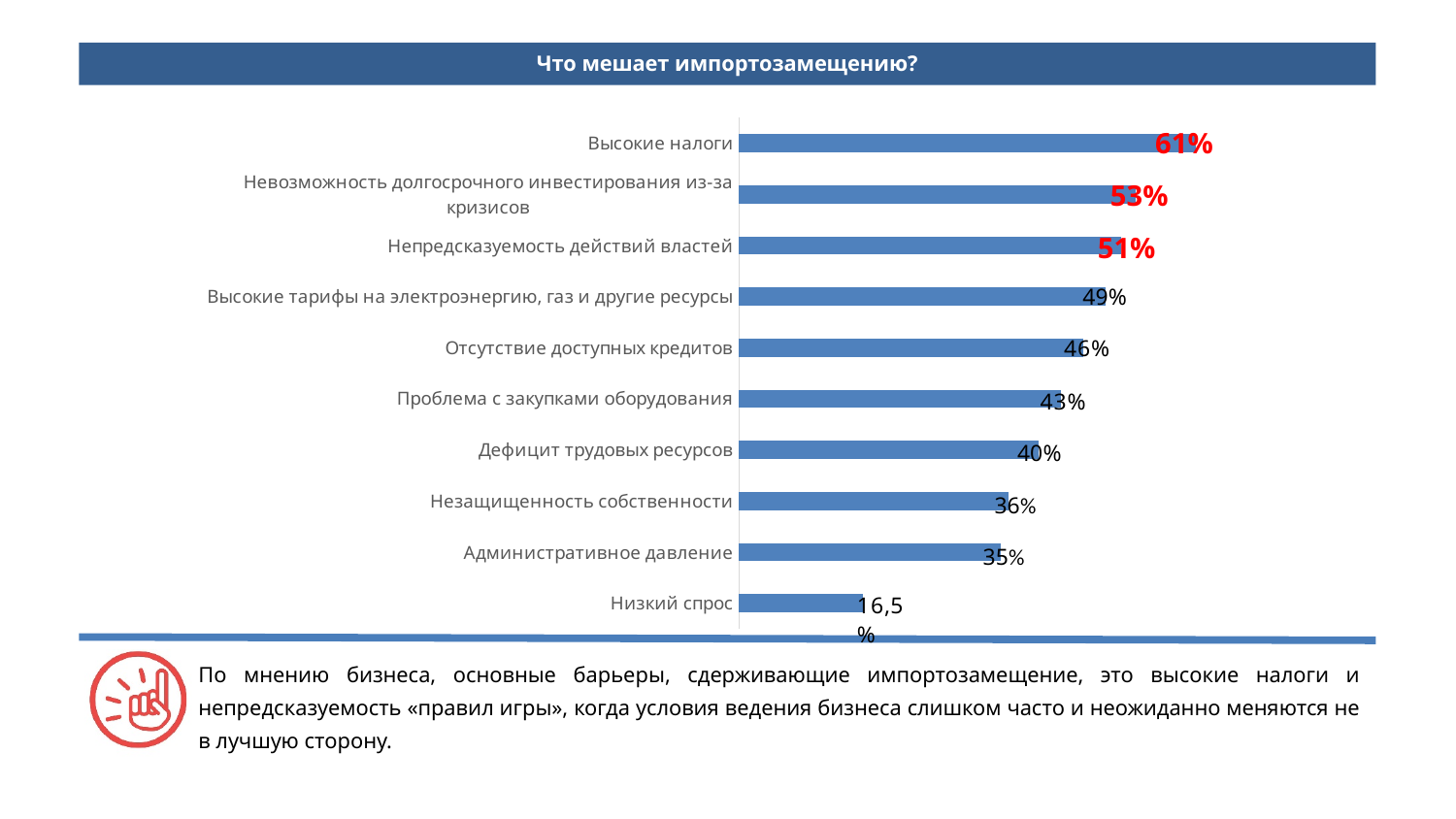
What is the value for «Дефицит трудовых ресурсов»? 40% Which category has the highest value? Высокие налоги What is the value for «Низкий спрос»? 16,5% How many categories are shown in the chart? 10 What kind of chart is shown on the slide? Bar chart What is the value for «Высокие налоги»? 61% What is the difference between the values for «Высокие налоги» and «Невозможность долгосрочного инвестирования из-за кризисов»? 8% Which category has the lowest value? Низкий спрос What is the title of the chart? Что мешает импортозамещению? Which is larger: the value for «Отсутствие доступных кредитов» or for «Проблема с закупками оборудования»? Отсутствие доступных кредитов What is the difference between the values for «Незащищенность собственности» and «Административное давление»? 1% What is the value for «Непредсказуемость действий властей»? 51%